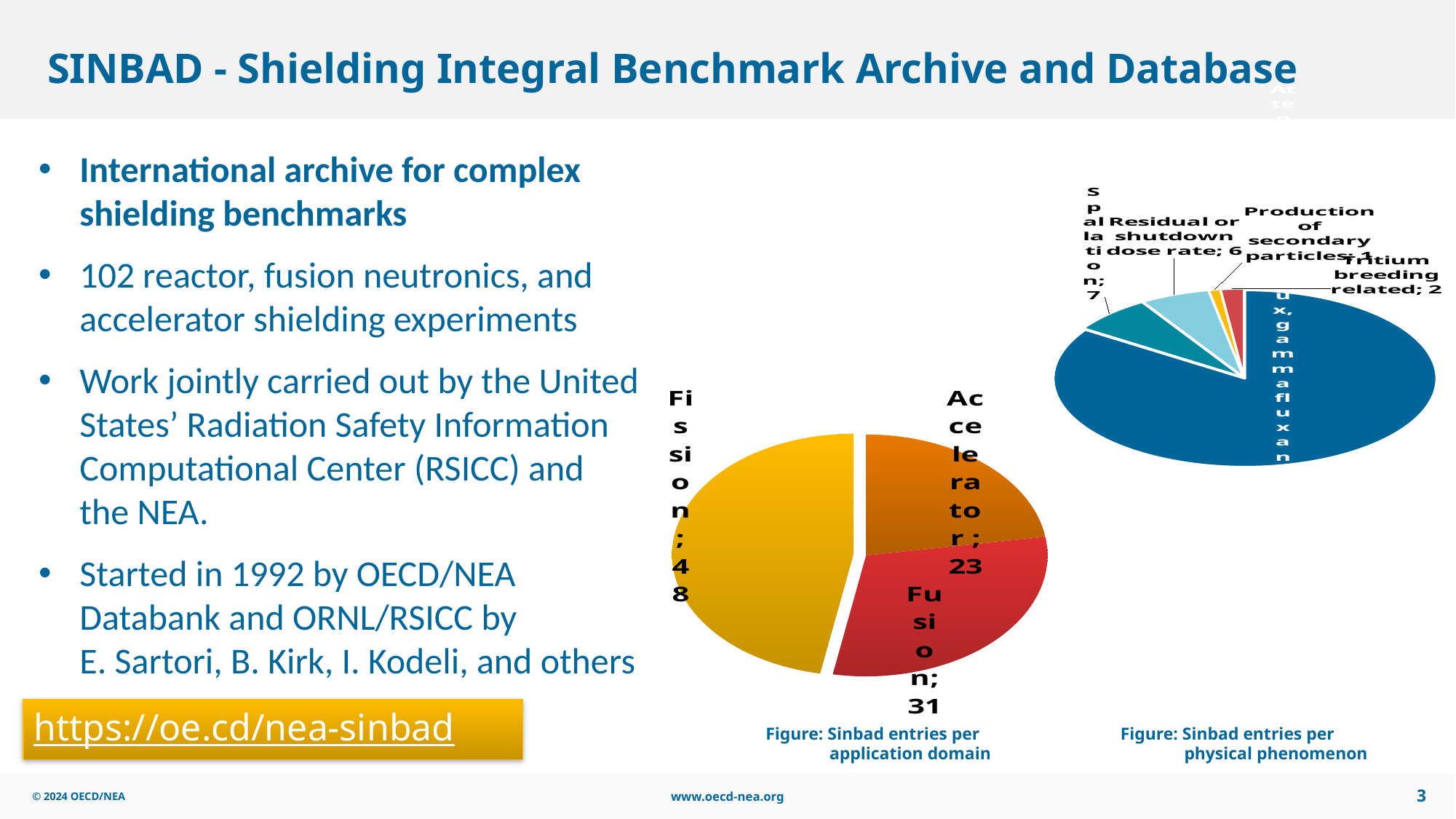
In the 'Sinbad entries per application domain' chart, what is the value for Fusion? 31 In the 'Sinbad entries per application domain' chart, which application domain has the most entries? Fission In the 'Sinbad entries per application domain' chart, what is the value for Accelerator? 23 In the 'Sinbad entries per physical phenomenon' chart, what is the value for Tritium breeding related? 2 In the 'Sinbad entries per application domain' chart, how many entries are in the Fission slice? 48 In the 'Sinbad entries per application domain' chart, which application domain has the fewest entries? Accelerator In the 'Sinbad entries per physical phenomenon' chart, what is the value for Production of secondary particles? 1 In the 'Sinbad entries per application domain' chart, how many more entries does Fission have than Fusion? 17 How many slices does the 'Sinbad entries per application domain' pie chart have? 3 In the 'Sinbad entries per physical phenomenon' chart, what is the value for Spallation? 7 What kind of chart is the 'Sinbad entries per application domain' figure? pie chart In the 'Sinbad entries per physical phenomenon' chart, what is the value for Residual or shutdown dose rate? 6